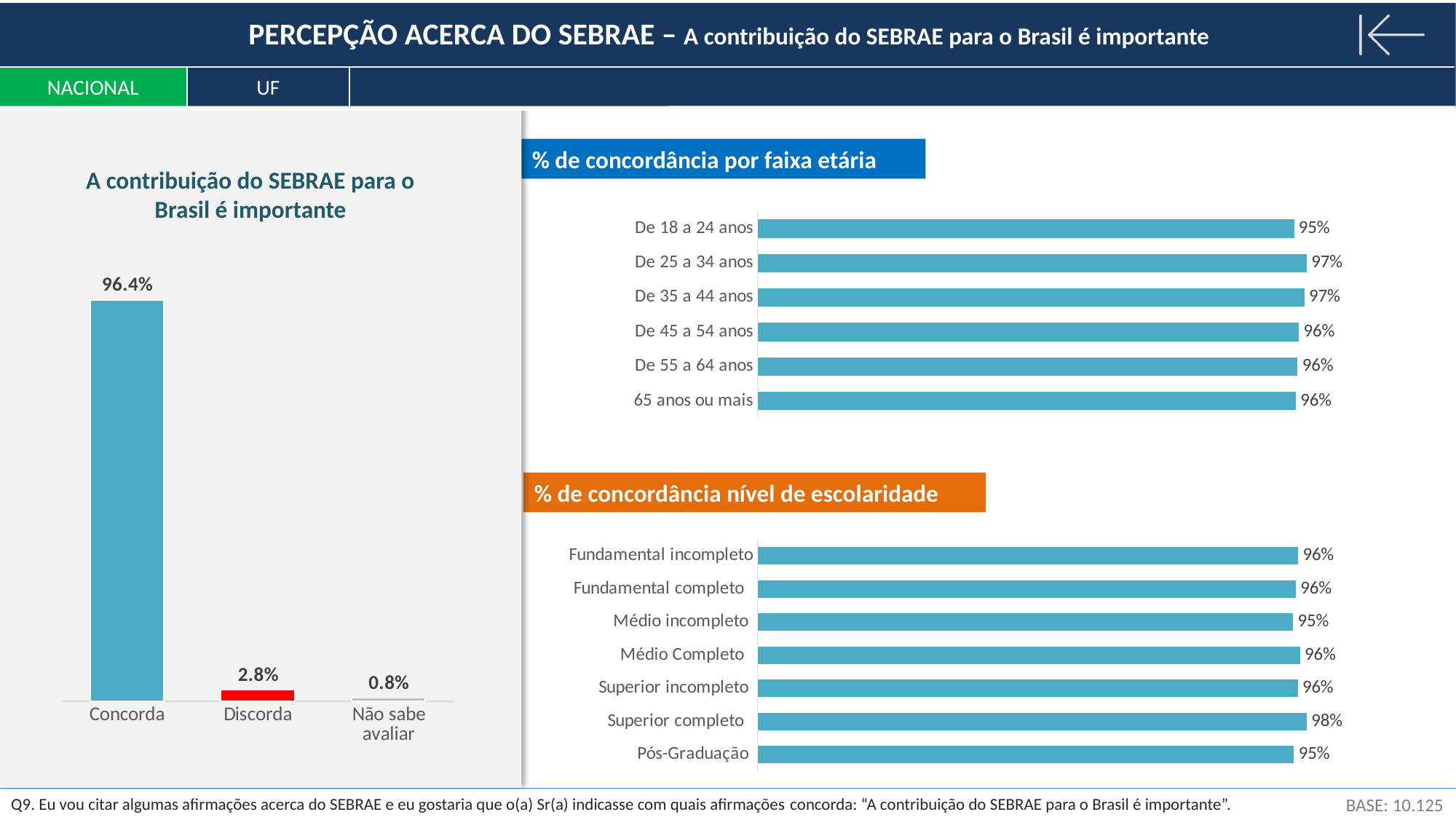
In the chart titled '% de concordância nível de escolaridade', how many education levels are shown? 7 In the chart titled 'A contribuição do SEBRAE para o Brasil é importante', what is the difference between Concorda and Discorda? 93.6% In the chart titled 'A contribuição do SEBRAE para o Brasil é importante', which category has the lowest value? Não sabe avaliar In the chart titled '% de concordância por faixa etária', what is the value for De 45 a 54 anos? 96% In the chart titled 'A contribuição do SEBRAE para o Brasil é importante', what is the value for Concorda? 96.4% In the chart titled 'A contribuição do SEBRAE para o Brasil é importante', how many categories are shown? 3 What type of chart is the chart titled '% de concordância nível de escolaridade'? Bar chart In the chart titled '% de concordância nível de escolaridade', what is the value for Pós-Graduação? 95% In the chart titled 'A contribuição do SEBRAE para o Brasil é importante', what is the value for Discorda? 2.8% In the chart titled '% de concordância nível de escolaridade', which category has the highest value? Superior completo In the chart titled '% de concordância por faixa etária', how many age groups are shown? 6 In the chart titled '% de concordância por faixa etária', what is the value for De 18 a 24 anos? 95%